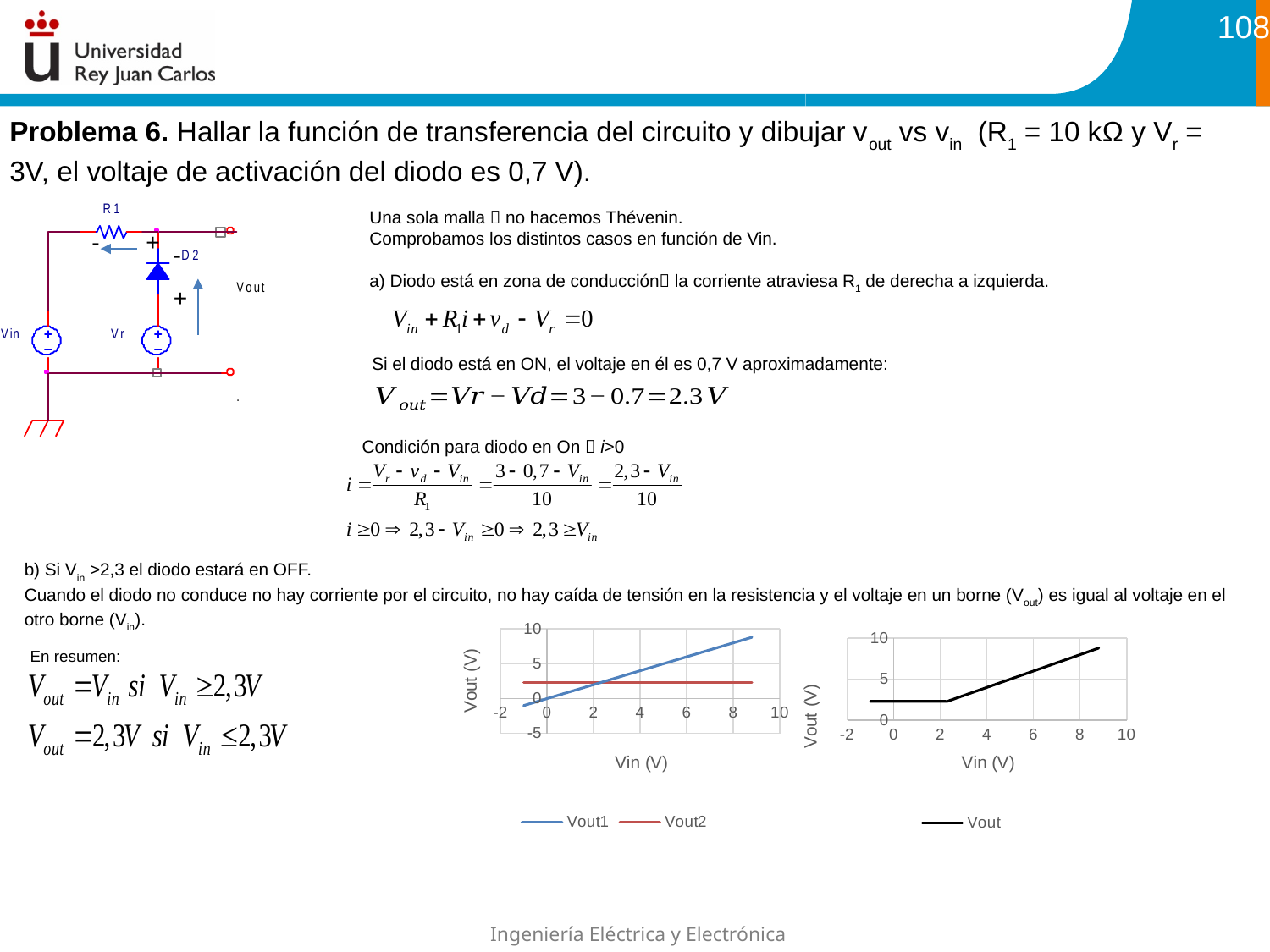
What kind of chart is the left chart with the Vout1 and Vout2 legend? line chart In the left chart, does the Vout2 series rise, fall, or stay flat as Vin increases? stay flat In the left chart, is the value of Vout1 at Vin = 8 greater or less than 5? greater What kind of chart is the right chart with the Vout legend? line chart In the right chart, is the value of Vout at Vin = 0 greater or less than 5? less In the right chart, does the Vout series rise or fall as Vin increases from 4 to 8? rise How many series does the legend of the right chart list? 1 In the left chart, what are the names of the two series in the legend? Vout1 and Vout2 How many series does the legend of the left chart list? 2 In the left chart, is the value of Vout2 greater or less than 5? less In the left chart, does the Vout1 series rise or fall as Vin increases? rise What is the x-axis title of the right chart? Vin (V)